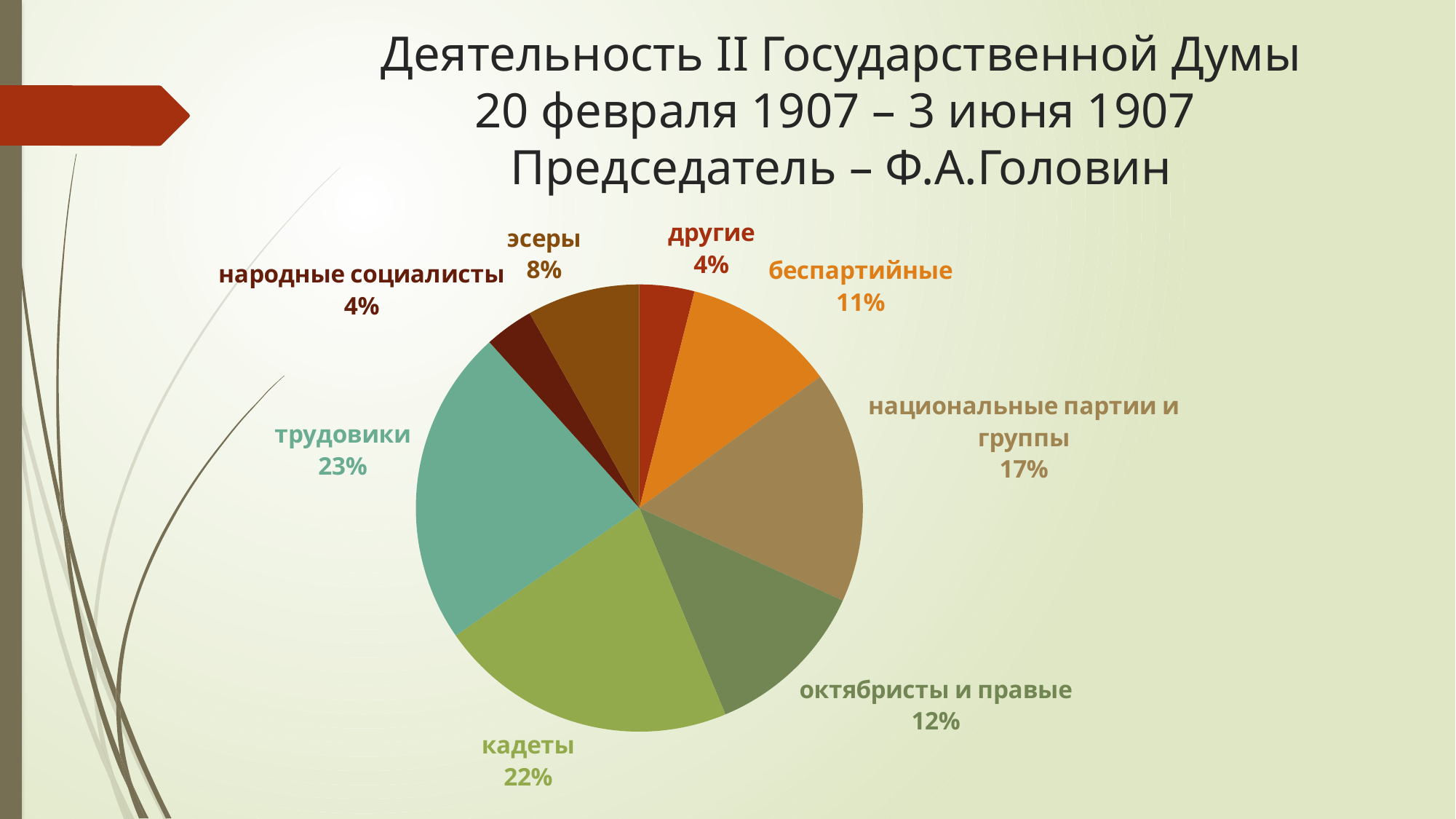
What is the value shown for беспартийные? 11% How many slices does the pie chart have? 8 Which is larger, the share for беспартийные or the share for октябристы и правые? октябристы и правые What is the value shown for национальные партии и группы? 17% What is the value shown for октябристы и правые? 12% What is the value shown for эсеры? 8% What kind of chart is shown on the slide? pie chart What is the difference between the shares of национальные партии и группы and эсеры? 9% What is the difference between the shares of трудовики and кадеты? 1% Which category has the largest share of the pie? трудовики What share of the pie does кадеты have? 22% What share of the pie does трудовики have? 23%